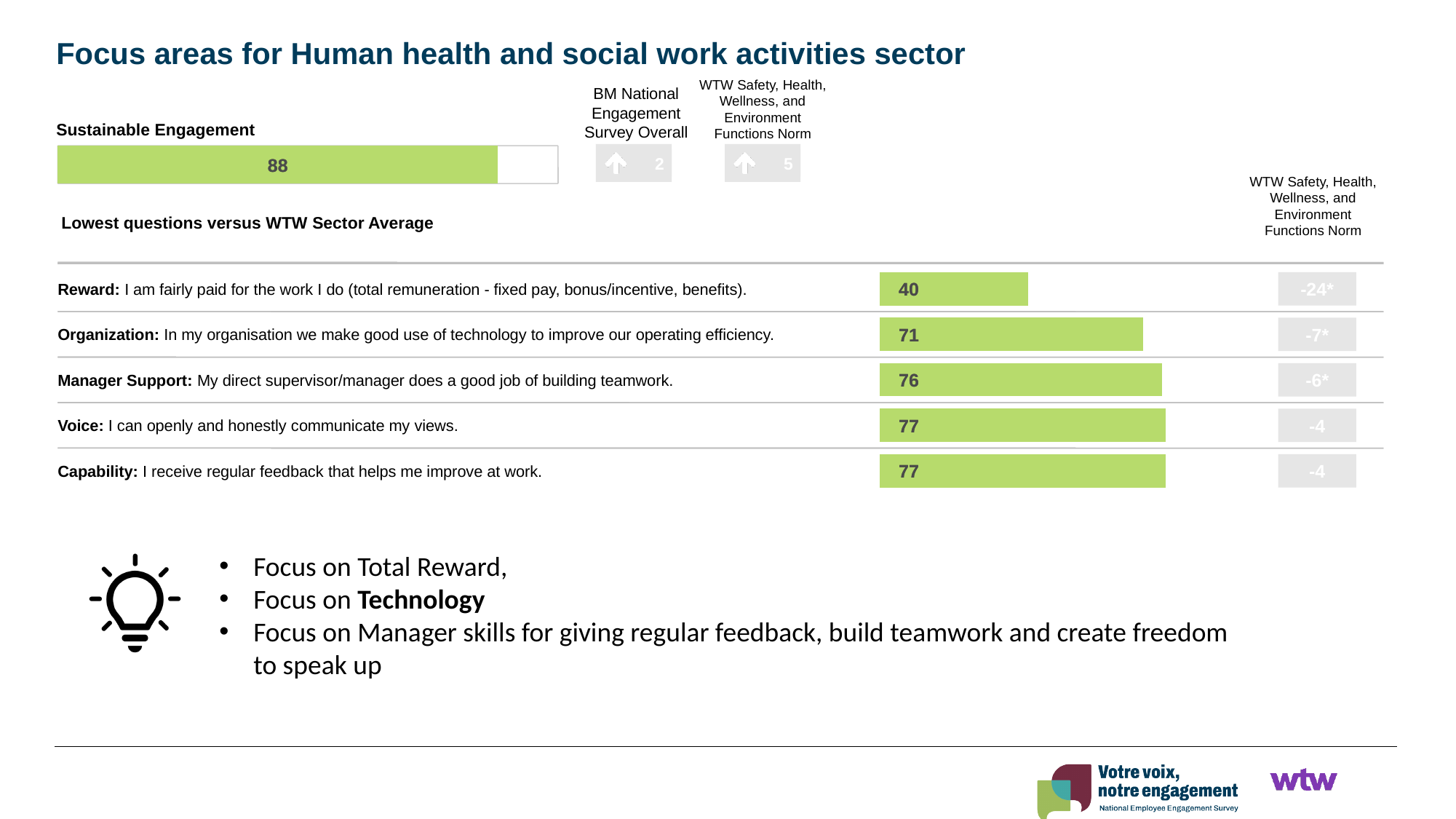
In the Lowest questions versus WTW Sector Average chart, what is the WTW Safety, Health, Wellness, and Environment Functions Norm difference shown for the Voice question? -4 In the Lowest questions versus WTW Sector Average chart, which question has the lowest value? Reward In the Lowest questions versus WTW Sector Average chart, what is the WTW Safety, Health, Wellness, and Environment Functions Norm difference shown for the Reward question? -24* In the Lowest questions versus WTW Sector Average chart, what is the value for the Reward question? 40 In the Lowest questions versus WTW Sector Average chart, which is larger, the value for Manager Support or the value for Organization? Manager Support In the Lowest questions versus WTW Sector Average chart, what is the value for the Organization question? 71 In the Lowest questions versus WTW Sector Average chart, what is the difference between the Organization value and the Reward value? 31 In the Sustainable Engagement chart, what is the difference shown versus the BM National Engagement Survey Overall? 2 In the Lowest questions versus WTW Sector Average chart, what is the value for the Manager Support question? 76 What kind of chart is the Lowest questions versus WTW Sector Average chart? Bar chart In the Sustainable Engagement bar at the top of the slide, what is the score shown? 88 How many questions are listed in the Lowest questions versus WTW Sector Average chart? 5